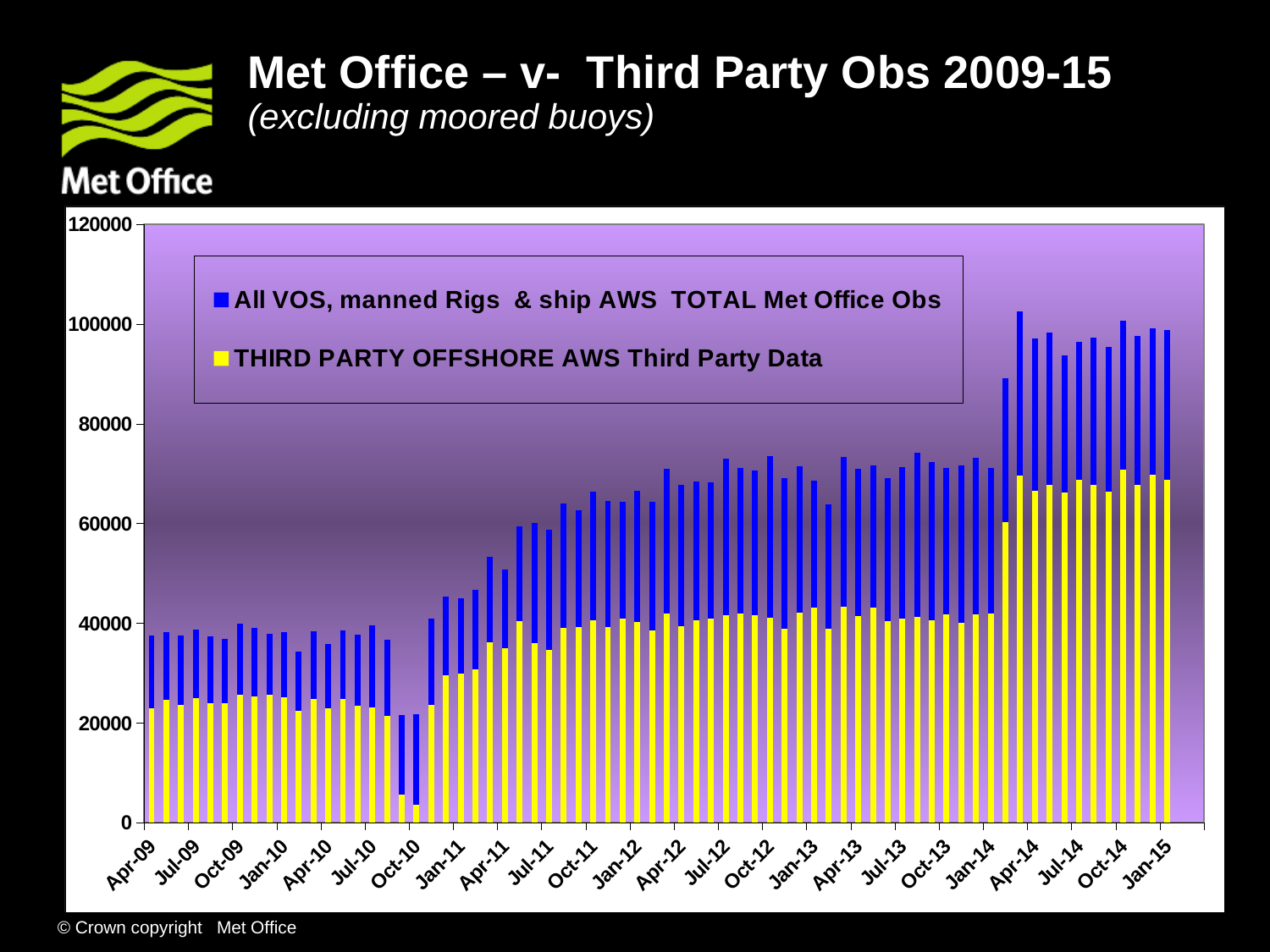
Is the THIRD PARTY OFFSHORE AWS value for Apr-09 greater or less than 40000? less Which has the larger total stacked value, Jan-14 or Apr-14? Apr-14 What is the highest value shown on the vertical axis? 120000 Is the total stacked value for Apr-14 greater or less than 80000? greater Is the total stacked value for Oct-10 greater or less than 40000? less Overall, do the total stacked values rise or fall from Apr-09 to Jan-15? rise Which colour represents the THIRD PARTY OFFSHORE AWS Third Party Data series? Yellow Which has the larger total stacked value, Apr-09 or Jan-15? Jan-15 How many series does the legend list? 2 What kind of chart is shown on the slide? Stacked bar chart